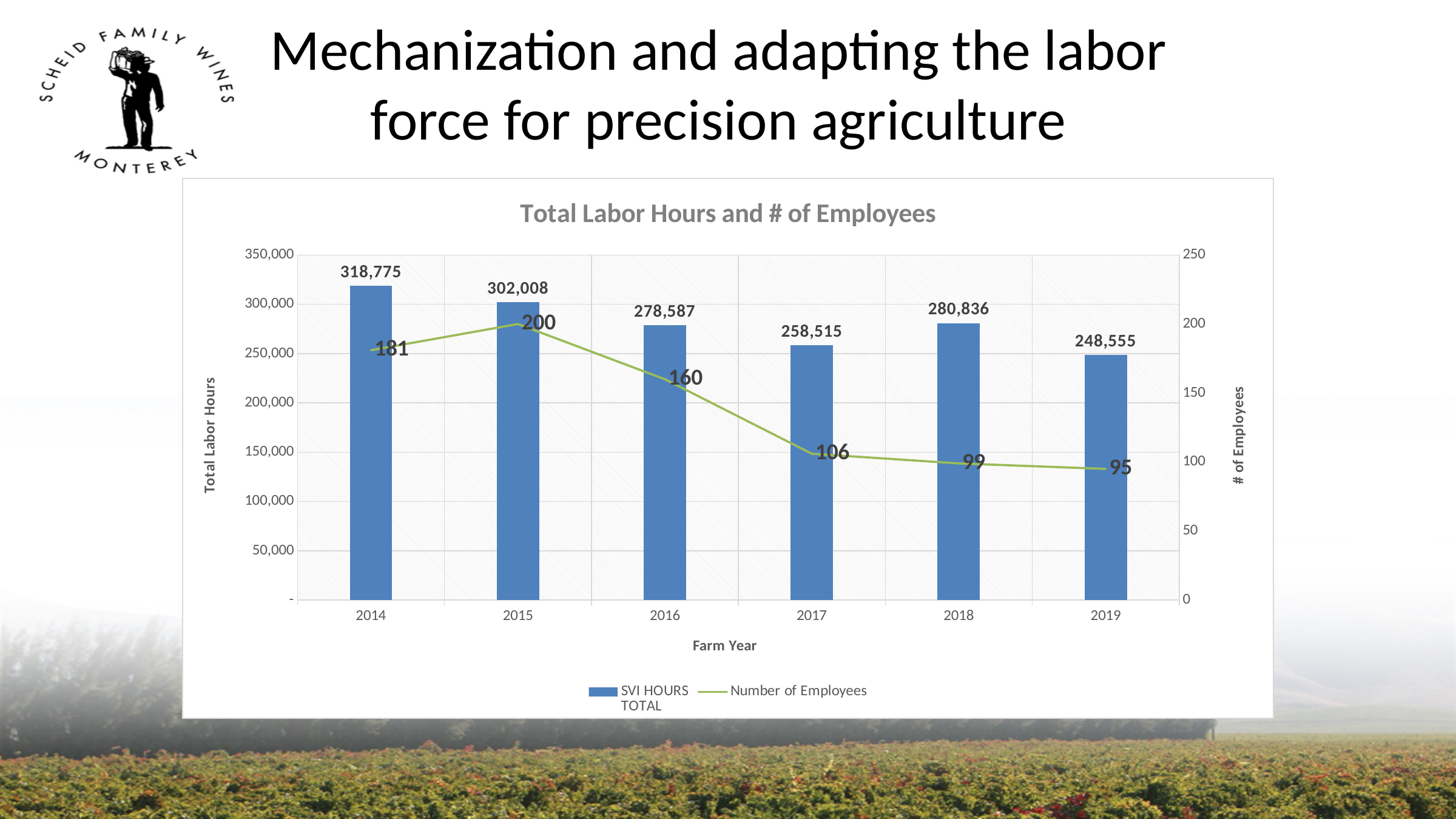
Which year has the lowest Number of Employees? 2019 Which year has the highest SVI HOURS TOTAL? 2014 How many series does the legend list? 2 Which year has the highest Number of Employees? 2015 What is the SVI HOURS TOTAL value for 2019? 248,555 What is the difference in Number of Employees between 2015 and 2019? 105 Which year has a higher SVI HOURS TOTAL, 2017 or 2018? 2018 What is the difference in SVI HOURS TOTAL between 2014 and 2019? 70,220 What is the SVI HOURS TOTAL value for 2014? 318,775 What is the Number of Employees in 2017? 106 How many farm years are shown on the x axis? 6 What is the title of the chart? Total Labor Hours and # of Employees